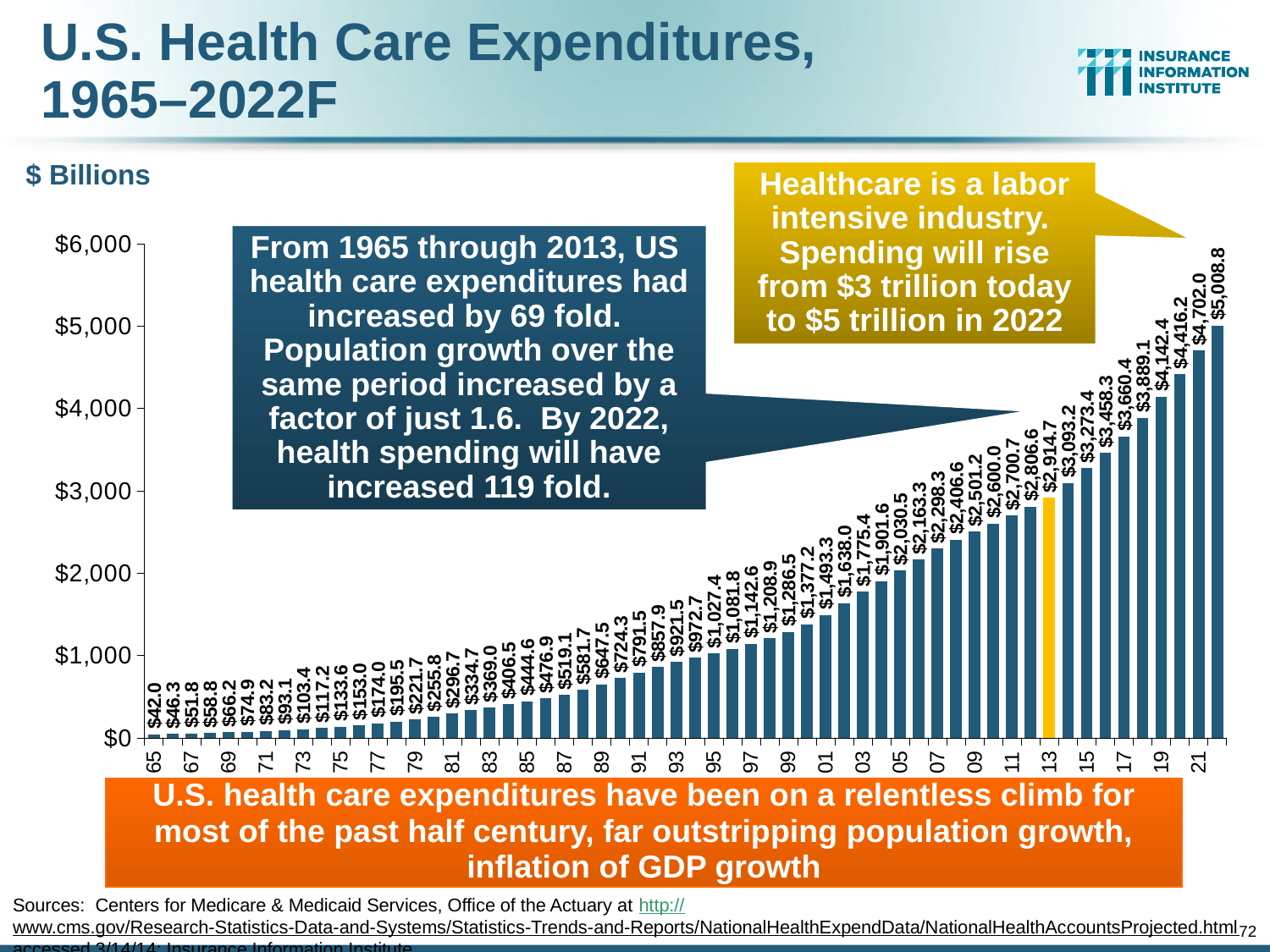
Which year has the lowest health care expenditure value in the chart? 1965 (65) How many bars (years) are plotted in the chart? 58 Do health care expenditures rise or fall over the years shown on the x axis? rise What is the value of the yellow highlighted bar (2013)? $2,914.7 What is the forecast health care expenditure value for 2022 (the last bar)? $5,008.8 What is the health care expenditure value for 2021? $4,702.0 What is the difference between the 2022 value and the 2013 value? $2,094.1 Is the value for 2013 greater or less than $3,000? less What is the difference between the 2022 value and the 1965 value? $4,966.8 What is the health care expenditure value for 1965 (the first bar)? $42.0 What kind of chart is shown on the slide? bar chart Which year has the highest health care expenditure value in the chart? 2022 (22)